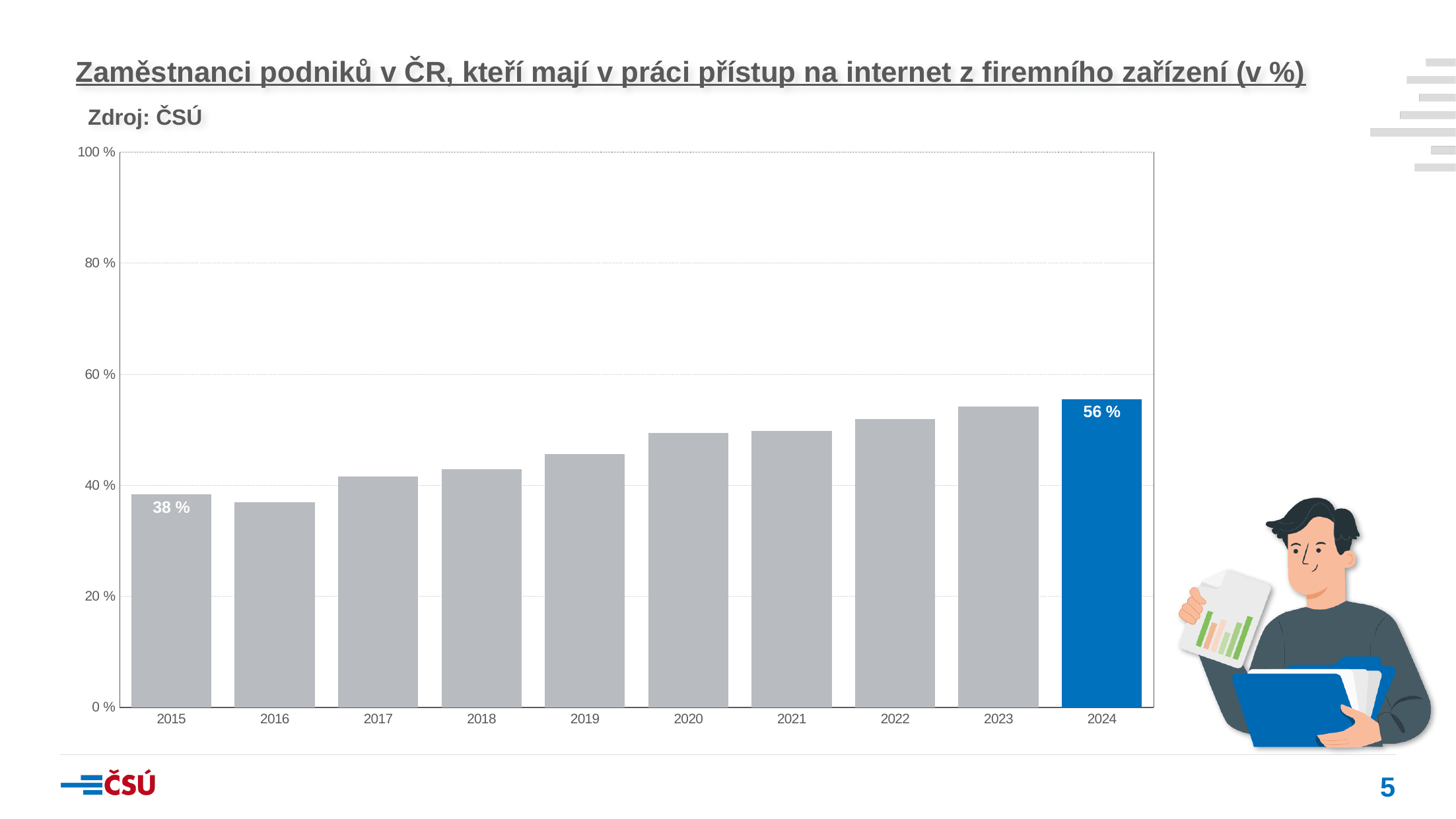
What is the difference between the values for 2024 and 2015? 18 percentage points Which is larger, the value for 2023 or the value for 2018? 2023 Which year has the highest value? 2024 What kind of chart is shown on the slide? bar chart What is the value for 2015? 38 % What is the value for 2024? 56 % Is the value for 2022 greater or less than 60 %? less Is the value for 2019 greater or less than 40 %? greater How many years are shown on the x axis? 10 What is the source given for the chart? ČSÚ Which year's bar is coloured blue instead of grey? 2024 Do the values generally rise or fall from 2015 to 2024? rise